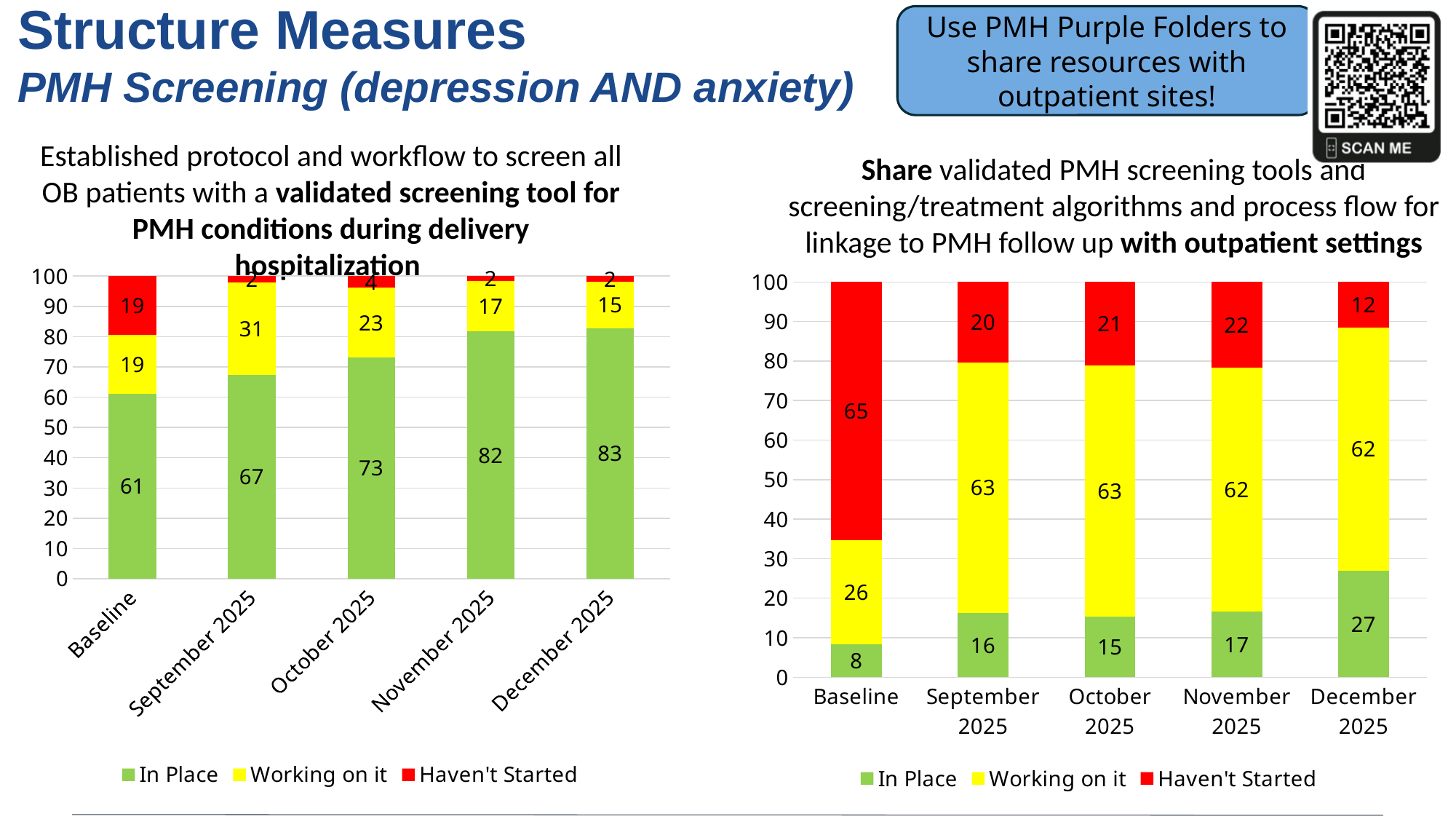
How many series does the legend of the right chart list? 3 How many categories are shown on the x axis of the left chart? 5 On the left chart, what is the Working on it value for September 2025? 31 On the right chart, is the In Place value for December 2025 greater or less than 20? greater On the right chart, which category has the lowest In Place value? Baseline On the left chart, which category has the highest In Place value? December 2025 On the right chart, which is larger: the Haven't Started value for Baseline or for December 2025? Baseline On the right chart, what is the In Place value for December 2025? 27 What kind of chart is the left chart? Stacked bar chart On the left chart, what is the In Place value for December 2025? 83 On the right chart, what is the Haven't Started value for Baseline? 65 On the left chart, what is the difference between the In Place values for December 2025 and Baseline? 22